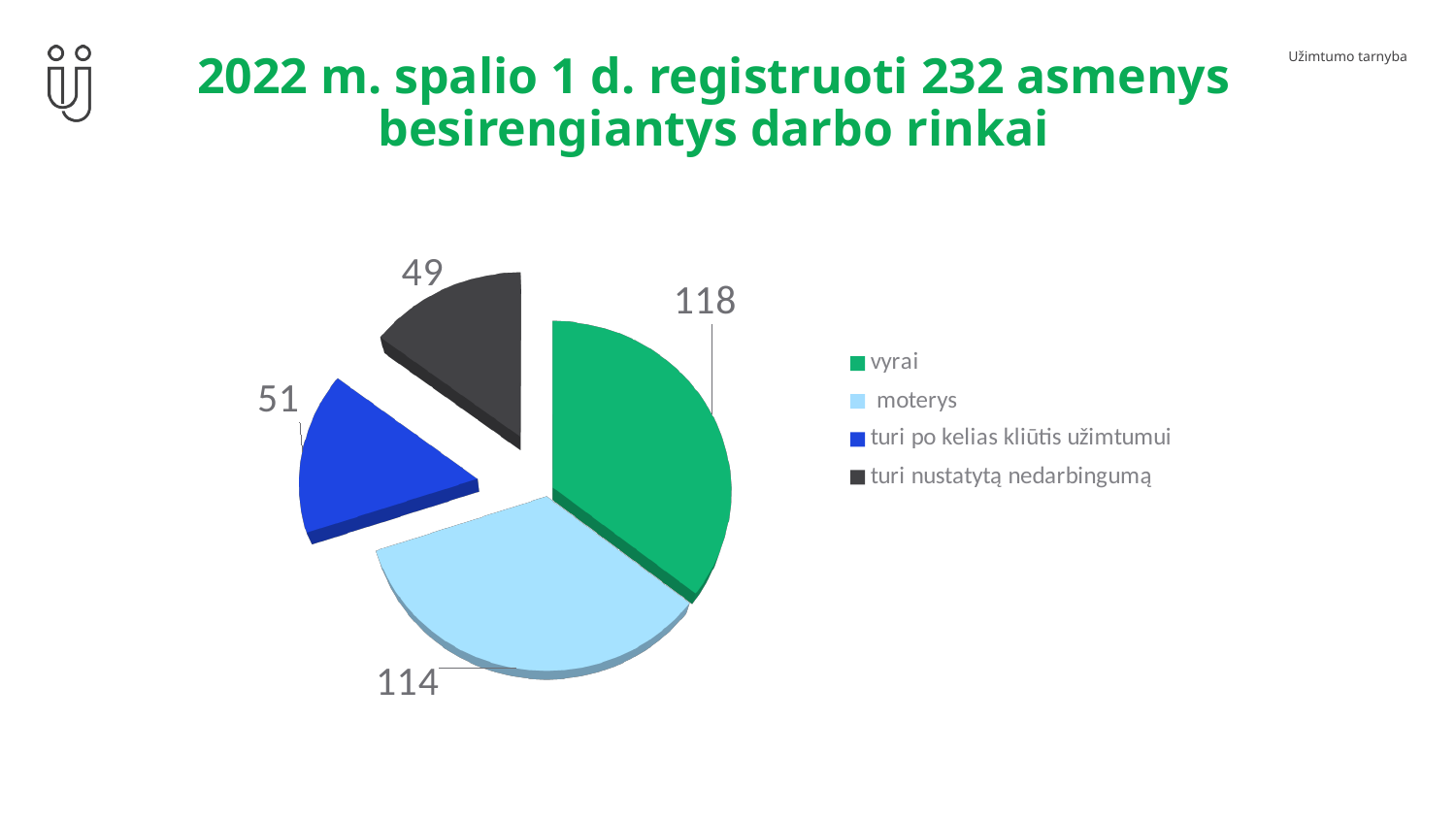
What is the value for turi nustatytą nedarbingumą? 49 What is the difference between the values for vyrai and moterys? 4 Which is larger, the value for moterys or the value for turi po kelias kliūtis užimtumui? moterys What is the value for moterys in the pie chart? 114 What is the difference between the values for turi po kelias kliūtis užimtumui and turi nustatytą nedarbingumą? 2 What colour is the slice for vyrai? green What kind of chart is shown on the slide? pie chart Which category has the smallest slice in the pie chart? turi nustatytą nedarbingumą What is the value for vyrai in the pie chart? 118 How many slices does the pie chart have? 4 Which category has the largest slice in the pie chart? vyrai What is the value for turi po kelias kliūtis užimtumui? 51